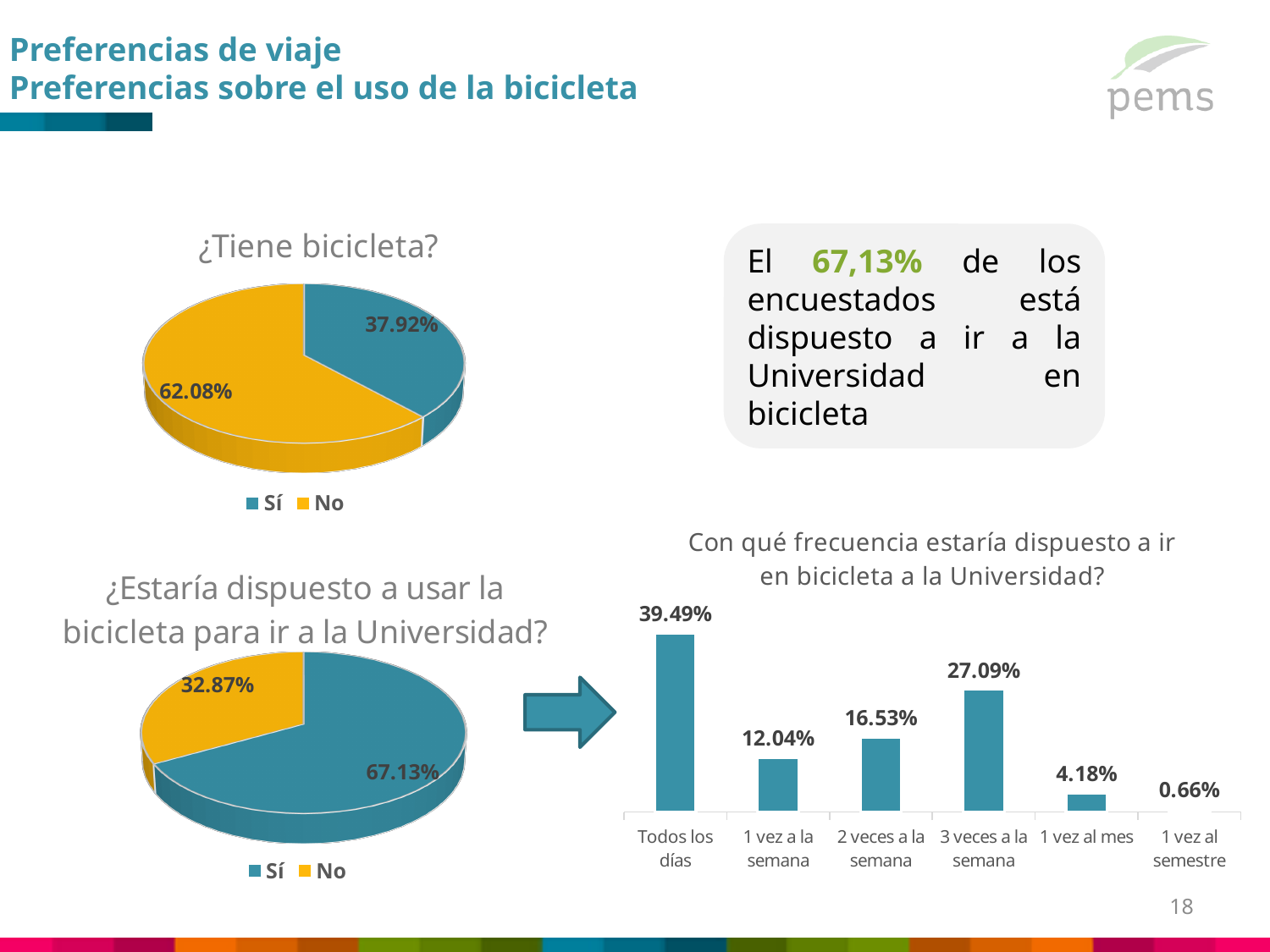
In the '¿Estaría dispuesto a usar la bicicleta para ir a la Universidad?' chart, what is the difference between the 'Sí' and 'No' shares? 34.26% In the '¿Tiene bicicleta?' chart, which answer has the larger share? No In the 'Con qué frecuencia estaría dispuesto a ir en bicicleta a la Universidad?' chart, which is larger: '1 vez al mes' or '2 veces a la semana'? 2 veces a la semana In the '¿Tiene bicicleta?' chart, what percentage answered 'No'? 62.08% In the 'Con qué frecuencia estaría dispuesto a ir en bicicleta a la Universidad?' chart, what is the value for '3 veces a la semana'? 27.09% In the 'Con qué frecuencia estaría dispuesto a ir en bicicleta a la Universidad?' chart, which category has the lowest value? 1 vez al semestre What kind of chart is '¿Estaría dispuesto a usar la bicicleta para ir a la Universidad?'? Pie chart In the 'Con qué frecuencia estaría dispuesto a ir en bicicleta a la Universidad?' chart, what is the value for 'Todos los días'? 39.49% In the 'Con qué frecuencia estaría dispuesto a ir en bicicleta a la Universidad?' chart, how many categories are shown? 6 In the '¿Estaría dispuesto a usar la bicicleta para ir a la Universidad?' chart, what percentage answered 'Sí'? 67.13% In the 'Con qué frecuencia estaría dispuesto a ir en bicicleta a la Universidad?' chart, what is the difference between '2 veces a la semana' and '1 vez a la semana'? 4.49% In the '¿Tiene bicicleta?' chart, what percentage answered 'Sí'? 37.92%